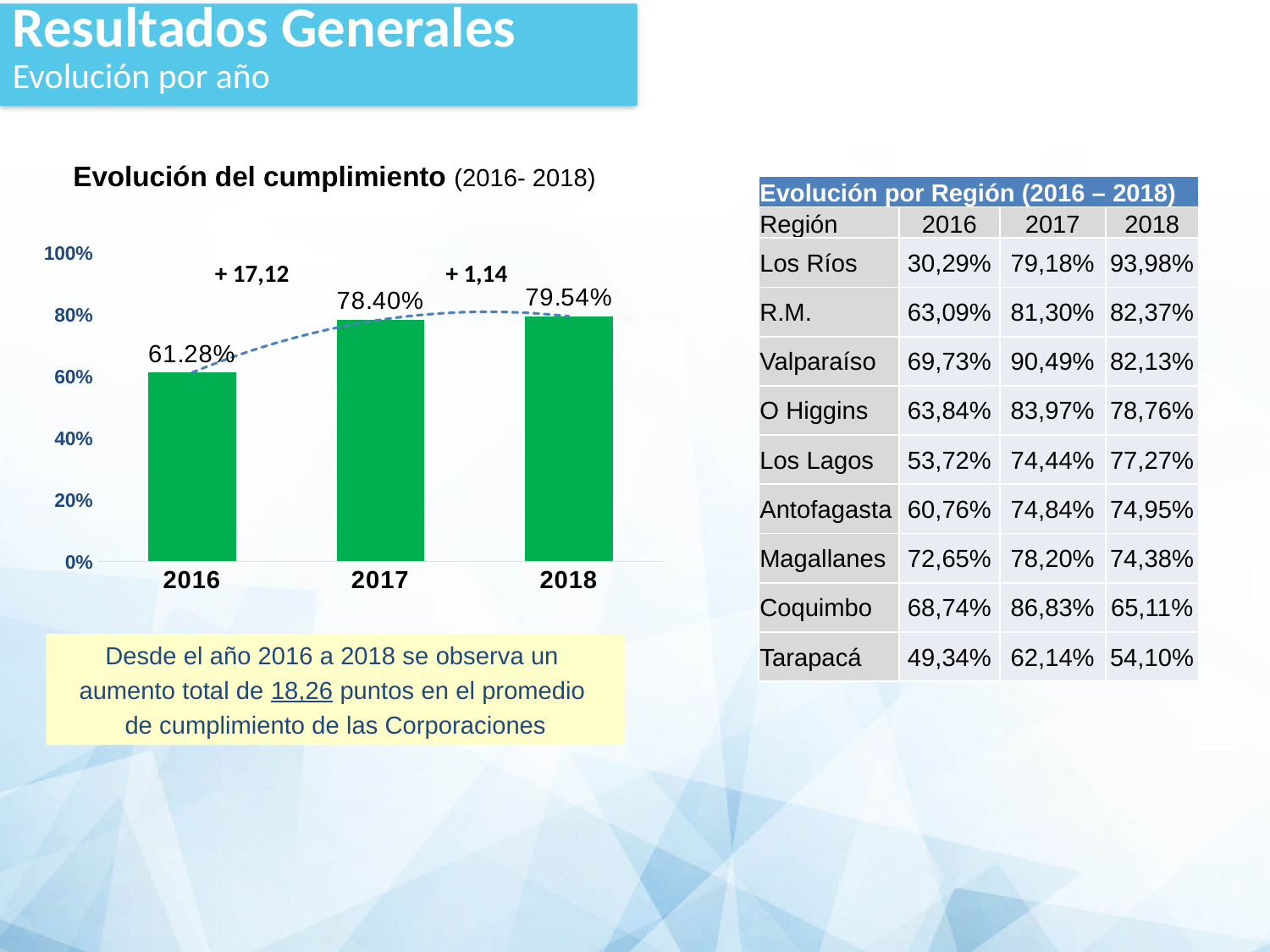
By how many percentage points did the value increase from 2016 to 2017 in the Evolución del cumplimiento chart? 17.12 By how many percentage points did the value increase from 2017 to 2018 in the Evolución del cumplimiento chart? 1.14 Is the value for 2016 in the Evolución del cumplimiento chart greater or less than 80%? less What type of chart is the Evolución del cumplimiento chart? bar chart What is the value shown for 2016 in the Evolución del cumplimiento chart? 61.28% In the Evolución del cumplimiento chart, is the value for 2017 or 2018 larger? 2018 What is the value shown for 2017 in the Evolución del cumplimiento chart? 78.40% What is the difference between the 2018 and 2016 values in the Evolución del cumplimiento chart? 18.26 Which year has the highest value in the Evolución del cumplimiento chart? 2018 How many years (bars) are plotted in the Evolución del cumplimiento chart? 3 What is the value shown for 2018 in the Evolución del cumplimiento chart? 79.54% Which year has the lowest value in the Evolución del cumplimiento chart? 2016